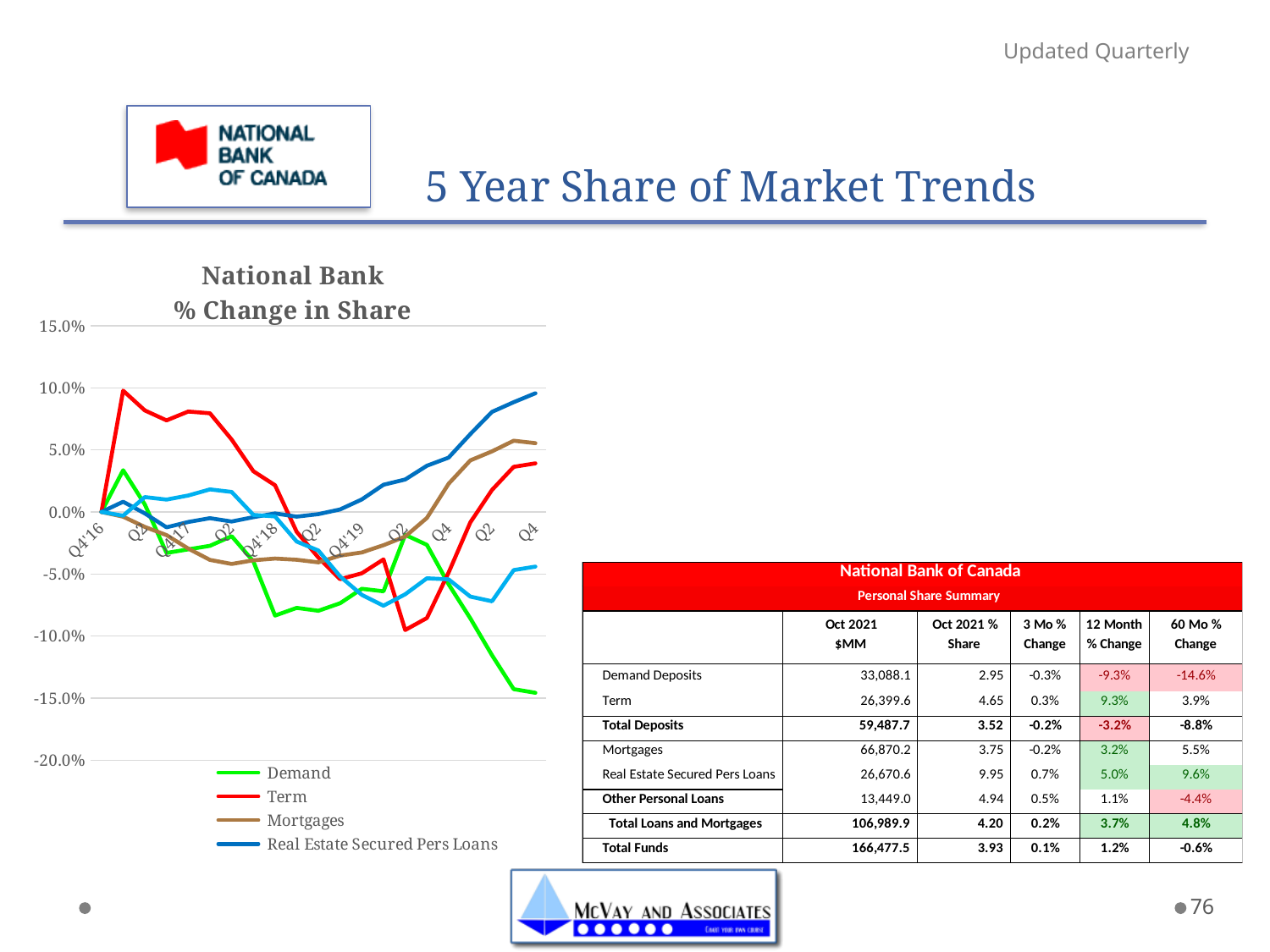
How many series does the chart legend list? 4 What colour is the Demand line in the chart? green What is the title of the chart? National Bank % Change in Share Is the value for Real Estate Secured Pers Loans at the final Q4 point greater or less than 5.0%? greater Is the value for Mortgages at the final Q4 point greater or less than 0.0%? greater What kind of chart is shown on the slide? line chart Is the value for Demand at the final Q4 point greater or less than -10.0%? less Which series ends highest at the final Q4 point on the chart? Real Estate Secured Pers Loans Which series ends lowest at the final Q4 point on the chart? Demand At the final Q4 point, which is larger: Real Estate Secured Pers Loans or Term? Real Estate Secured Pers Loans Does the Demand line rise or fall from Q4'19 to the final Q4 point? fall